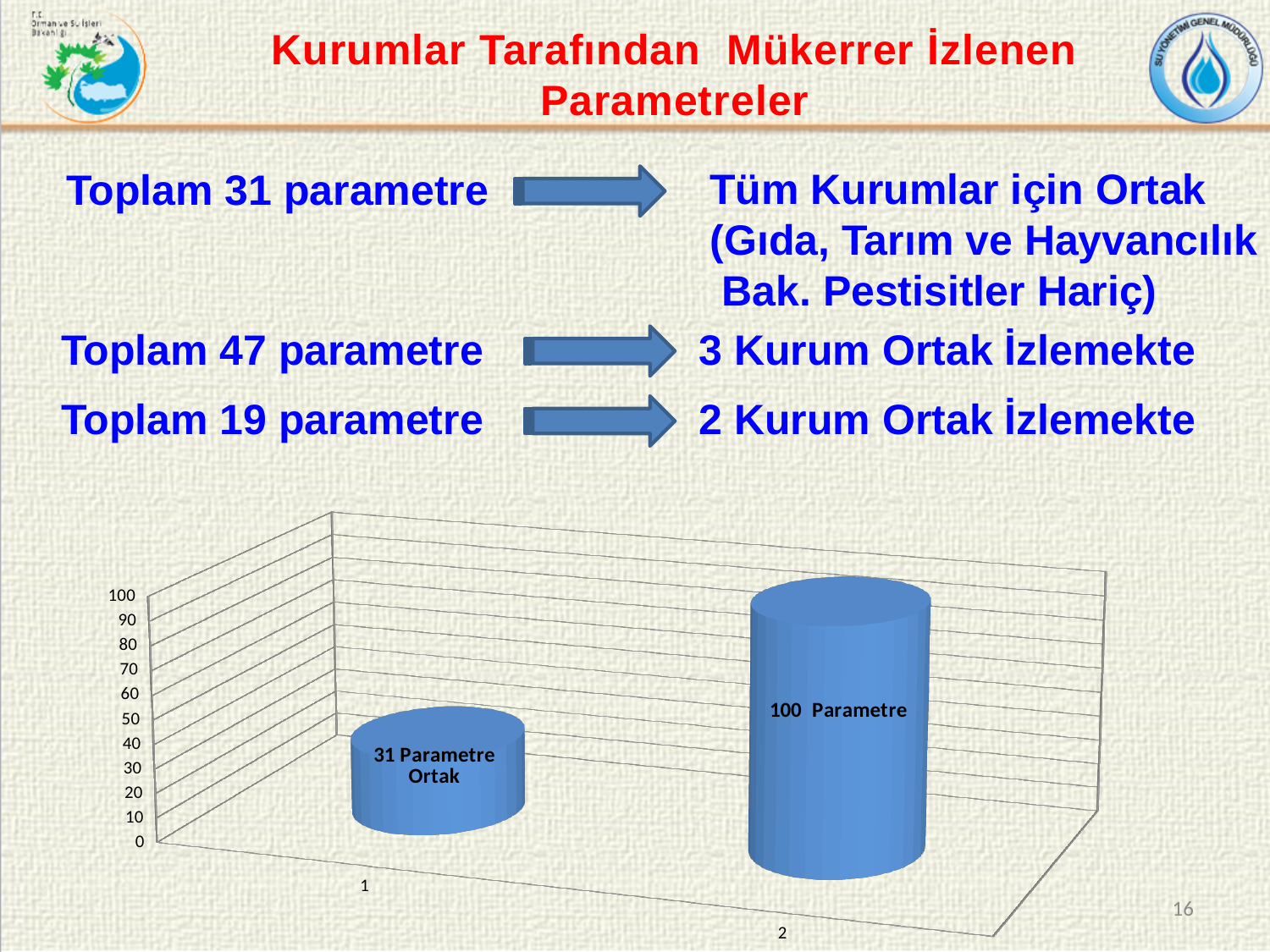
Which category has the taller bar? 2 Which category has the shorter bar? 1 Is the value for category 1 greater or less than 50? less What value is labelled on the bar for category 2? 100 Parametre Is the value for category 2 greater or less than 90? greater What is the highest tick value shown on the vertical axis? 100 What kind of chart is shown at the bottom of the slide? bar chart How many bars does the chart show? 2 What colour are the bars in the chart? blue What value is labelled on the bar for category 1? 31 Parametre Ortak What is the difference between the value for category 2 and the value for category 1? 69 Which is larger, the value for category 1 or the value for category 2? category 2